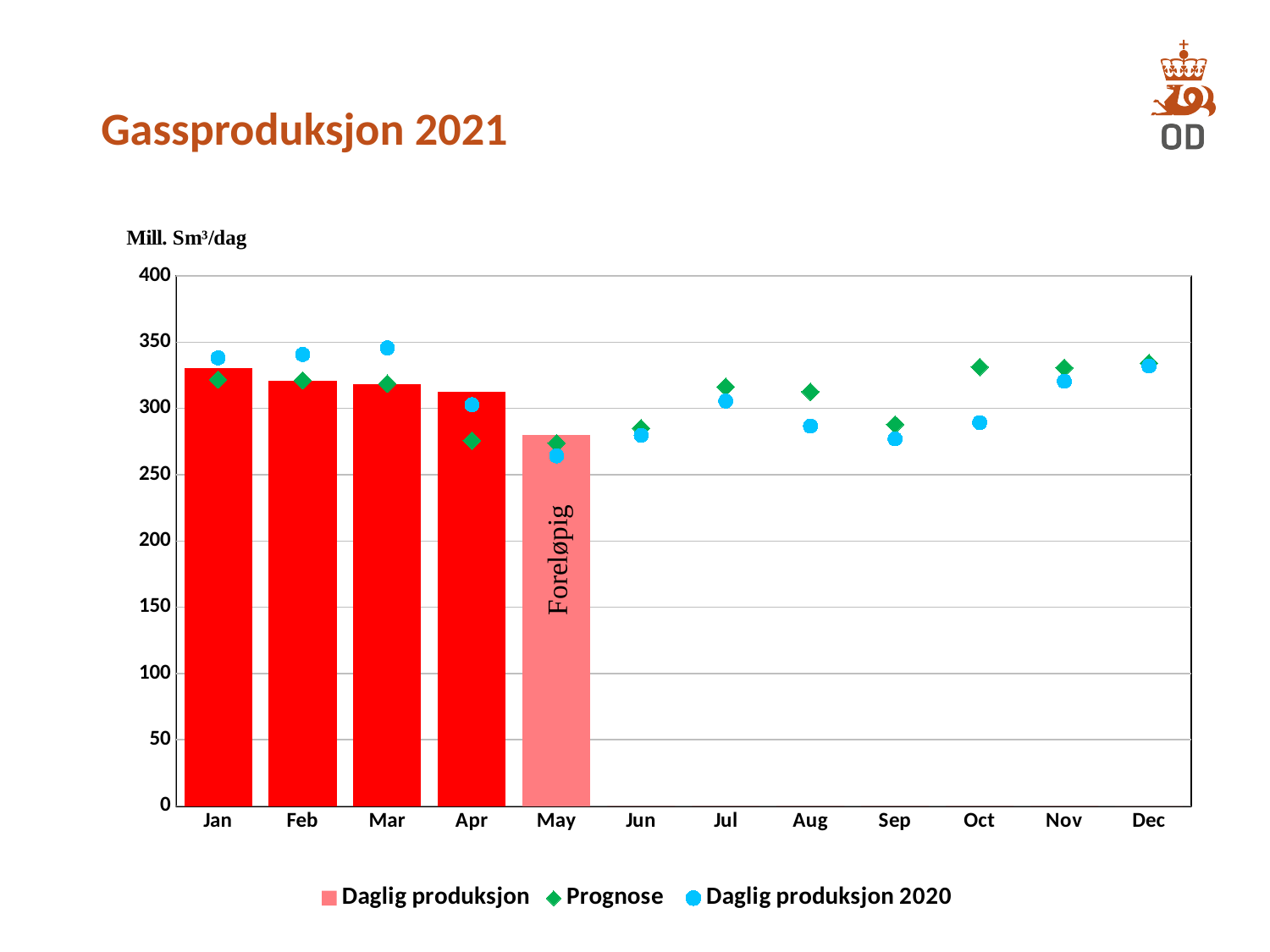
Which month has the highest Daglig produksjon bar? Jan How many months are shown on the x axis? 12 Is the Daglig produksjon value for Jan greater or less than 300? greater In Apr, which is larger: the Prognose value or the Daglig produksjon 2020 value? Daglig produksjon 2020 Which month has the lowest Daglig produksjon bar? May Is the Prognose value for Apr greater or less than 300? less Do the Daglig produksjon bars rise or fall from Jan to May? fall How many series does the legend list? 3 What kind of chart is shown on the slide? combination bar and line chart (bars with point markers) Is the Daglig produksjon 2020 value for Mar greater or less than 300? greater What word is written on the May bar? Foreløpig